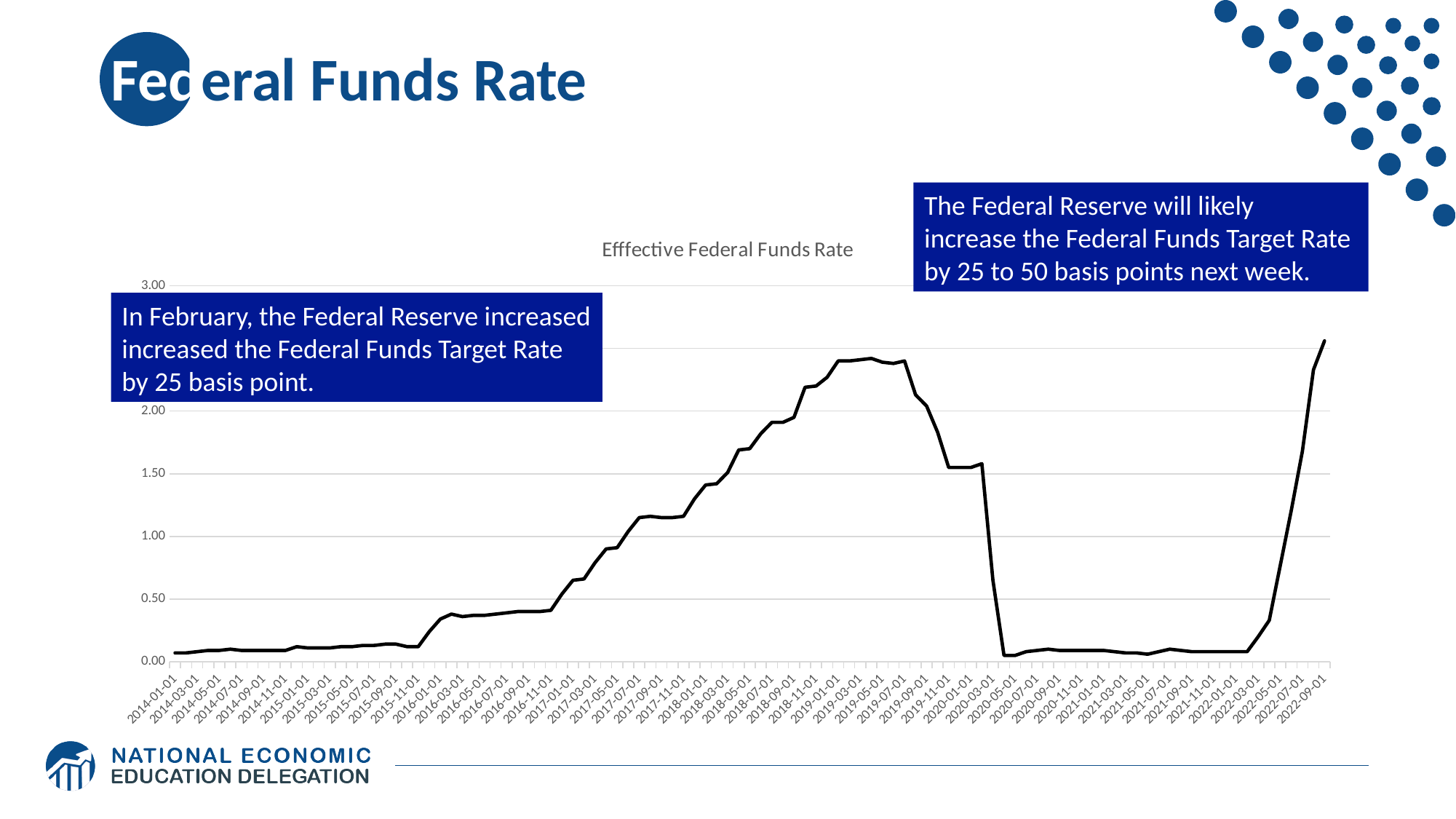
Is the value for 2022-09-01 greater or less than 2.00? greater Is the value for 2018-09-01 greater or less than 1.50? greater Is the value for 2017-09-01 greater or less than 1.50? less Does the line rise or fall between 2019-07-01 and 2020-05-01? fall What is the title of the chart? Efffective Federal Funds Rate What kind of chart is shown on the slide? line chart Does the line rise or fall between 2016-11-01 and 2019-03-01? rise What is the highest value shown on the chart's vertical axis? 3.00 At which x-axis date does the line reach its highest value? 2022-09-01 Which is larger, the value for 2019-03-01 or the value for 2020-07-01? 2019-03-01